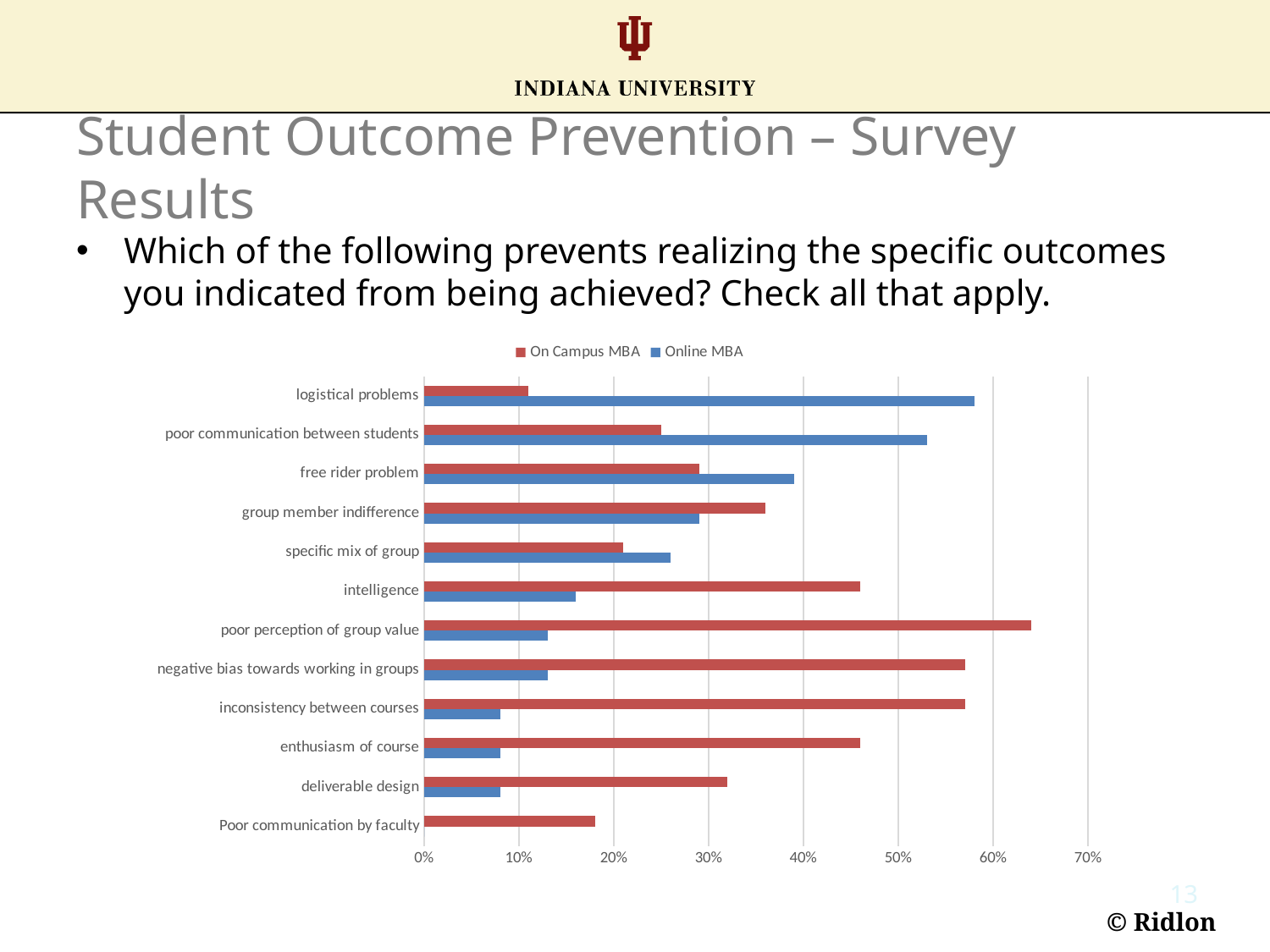
What kind of chart is shown on the slide? bar chart How many series does the chart's legend list? 2 For intelligence, which series has the larger value, On Campus MBA or Online MBA? On Campus MBA For free rider problem, which series has the larger value, On Campus MBA or Online MBA? Online MBA Is the On Campus MBA value for poor perception of group value greater or less than 60%? greater Which category has the highest value for the Online MBA series? logistical problems Is the Online MBA value for logistical problems greater or less than 50%? greater Which category has the highest value for the On Campus MBA series? poor perception of group value Which category has the lowest value for the On Campus MBA series? logistical problems How many categories are plotted on the chart? 12 For logistical problems, which series has the larger value, On Campus MBA or Online MBA? Online MBA Is the Online MBA value for inconsistency between courses greater or less than 10%? less